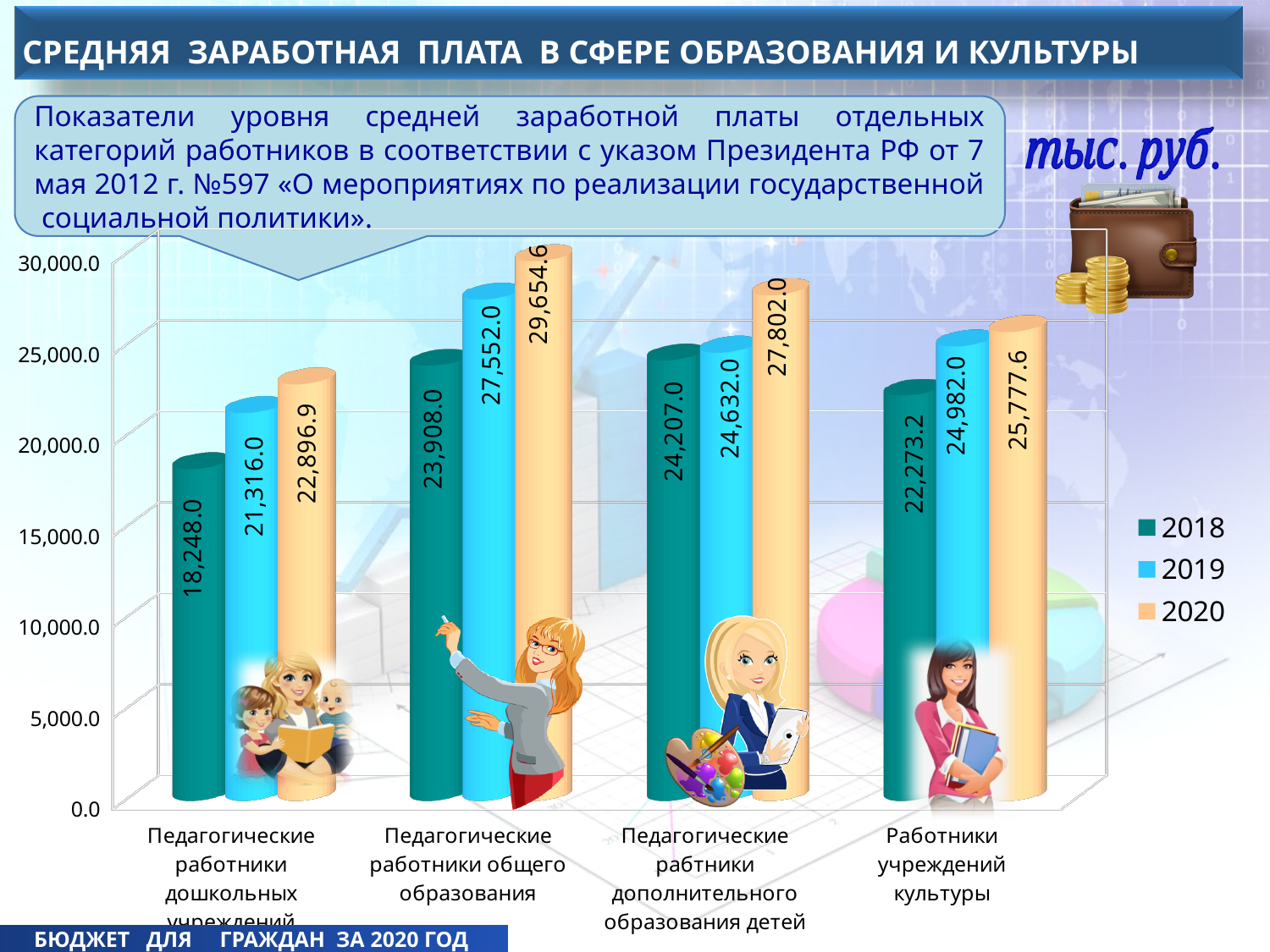
Which category had the highest average salary in 2020? Педагогические работники общего образования What was the average salary for Работники учреждений культуры in 2019? 24,982.0 What is the difference between the 2020 and 2019 values for Работники учреждений культуры? 795.6 What type of chart is shown on the slide? Bar chart Do the values for Работники учреждений культуры rise or fall from 2018 to 2020? Rise What was the average salary for Педагогические работники дошкольных учреждений in 2018? 18,248.0 Which category had the lowest average salary in 2018? Педагогические работники дошкольных учреждений What was the average salary for Педагогические работники общего образования in 2020? 29,654.6 By how much did the average salary for Педагогические работники дошкольных учреждений increase from 2018 to 2020? 4,648.9 How many categories of workers are shown on the chart? 4 Which is larger: the 2019 value for Педагогические работники общего образования or the 2020 value for Педагогические работники дополнительного образования детей? 2020 value for Педагогические работники дополнительного образования детей How many series does the legend list? 3